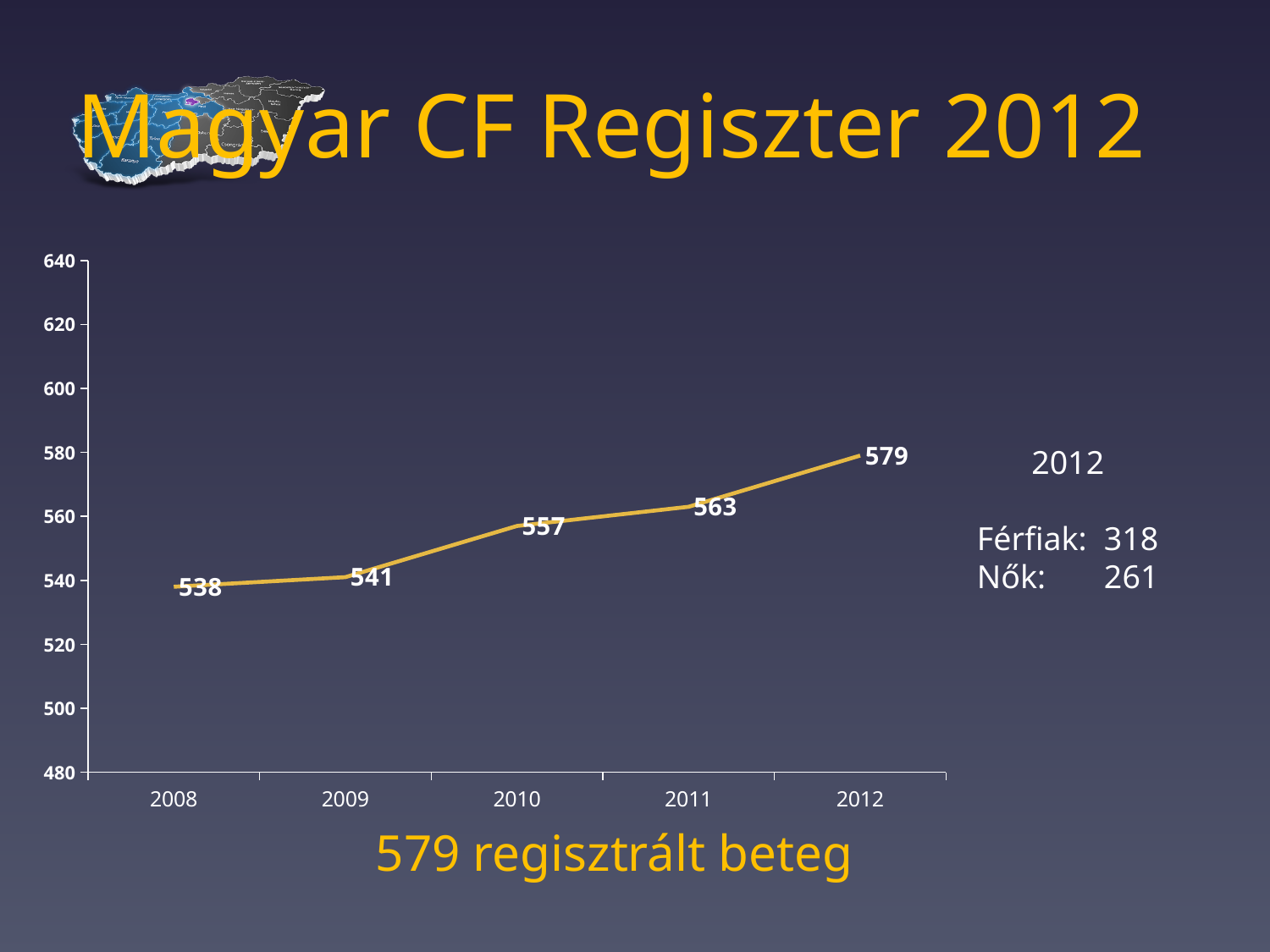
Do the values rise or fall from 2008 to 2012? rise What is the value for 2010? 557 What is the value for 2008? 538 How many years are plotted on the chart? 5 Which year has the highest value? 2012 Is the value for 2011 greater or less than 580? less What is the difference between the values for 2010 and 2009? 16 What is the difference between the values for 2012 and 2008? 41 Which is larger, the value for 2011 or the value for 2009? 2011 Which year has the lowest value? 2008 What is the value for 2012? 579 What kind of chart is shown on the slide? line chart